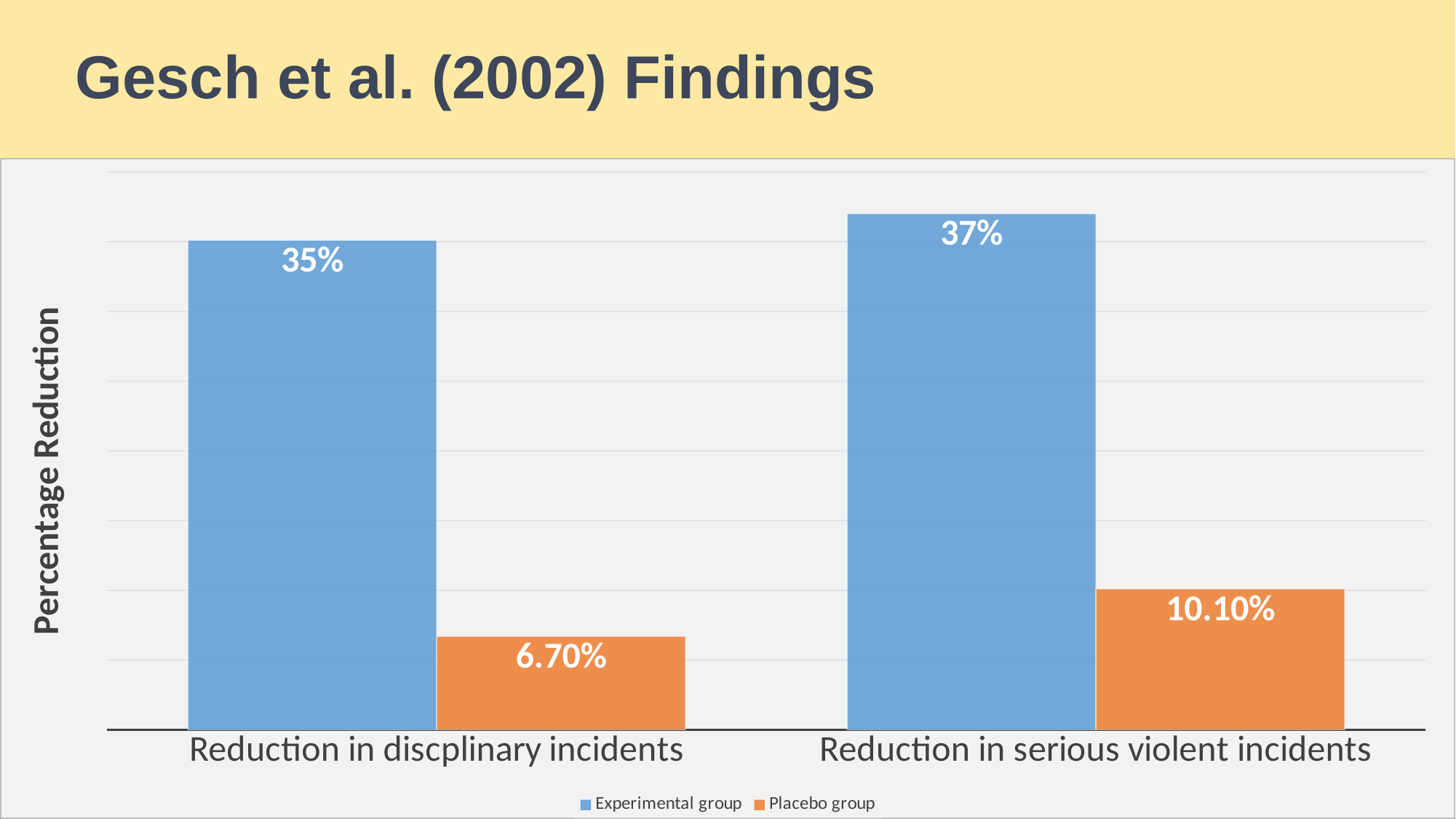
What is the value for the Experimental group for Reduction in serious violent incidents? 37% What is the difference between the Experimental group and Placebo group values for Reduction in serious violent incidents? 26.90% Which category has the highest Experimental group value? Reduction in serious violent incidents What is the value for the Experimental group for Reduction in discplinary incidents? 35% Which category has the lowest Placebo group value? Reduction in discplinary incidents What kind of chart is shown on the slide? Bar chart How many series does the legend list? 2 What is the difference between the Placebo group values for Reduction in serious violent incidents and Reduction in discplinary incidents? 3.40% How many categories are shown on the x axis? 2 What is the value for the Placebo group for Reduction in serious violent incidents? 10.10% Which is larger for Reduction in discplinary incidents: the Experimental group or the Placebo group? Experimental group What is the value for the Placebo group for Reduction in discplinary incidents? 6.70%